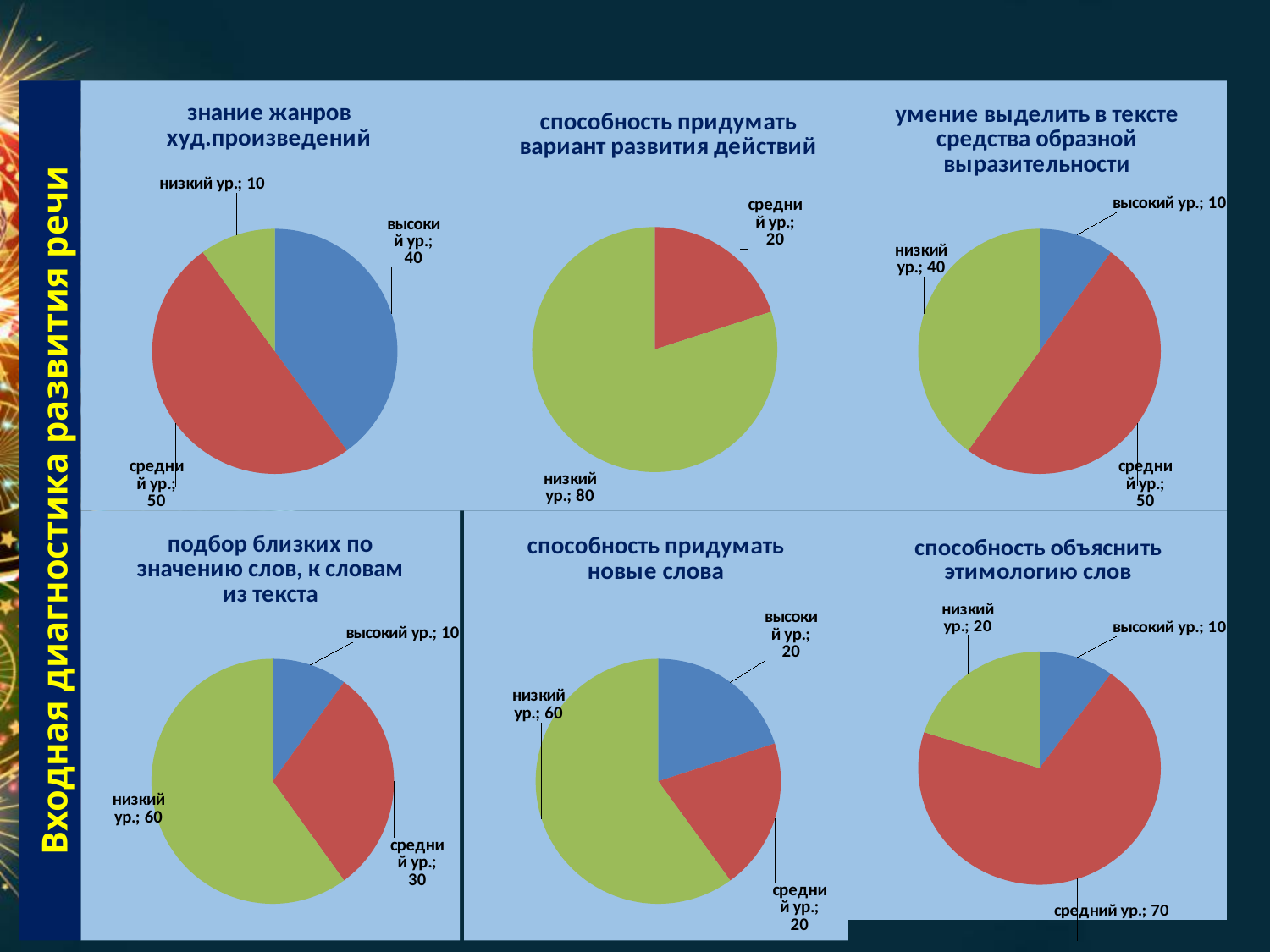
In the chart titled 'способность придумать вариант развития действий', what is the value for 'низкий ур.'? 80 In the chart titled 'знание жанров худ.произведений', which category has the smallest slice? низкий ур. How many pie charts are shown on the slide? 6 In the chart titled 'умение выделить в тексте средства образной выразительности', what is the difference between 'средний ур.' and 'низкий ур.'? 10 In the chart titled 'способность придумать новые слова', what is the difference between 'низкий ур.' and 'высокий ур.'? 40 How many slices does the chart titled 'способность придумать вариант развития действий' have? 2 In the chart titled 'умение выделить в тексте средства образной выразительности', which category has the largest slice? средний ур. In the chart titled 'способность объяснить этимологию слов', what is the value for 'средний ур.'? 70 In the chart titled 'подбор близких по значению слов, к словам из текста', which is larger, 'средний ур.' or 'высокий ур.'? средний ур. In the chart titled 'знание жанров худ.произведений', what is the value for 'средний ур.'? 50 What type of chart is used for 'способность объяснить этимологию слов'? pie chart In the chart titled 'подбор близких по значению слов, к словам из текста', what is the value for 'низкий ур.'? 60